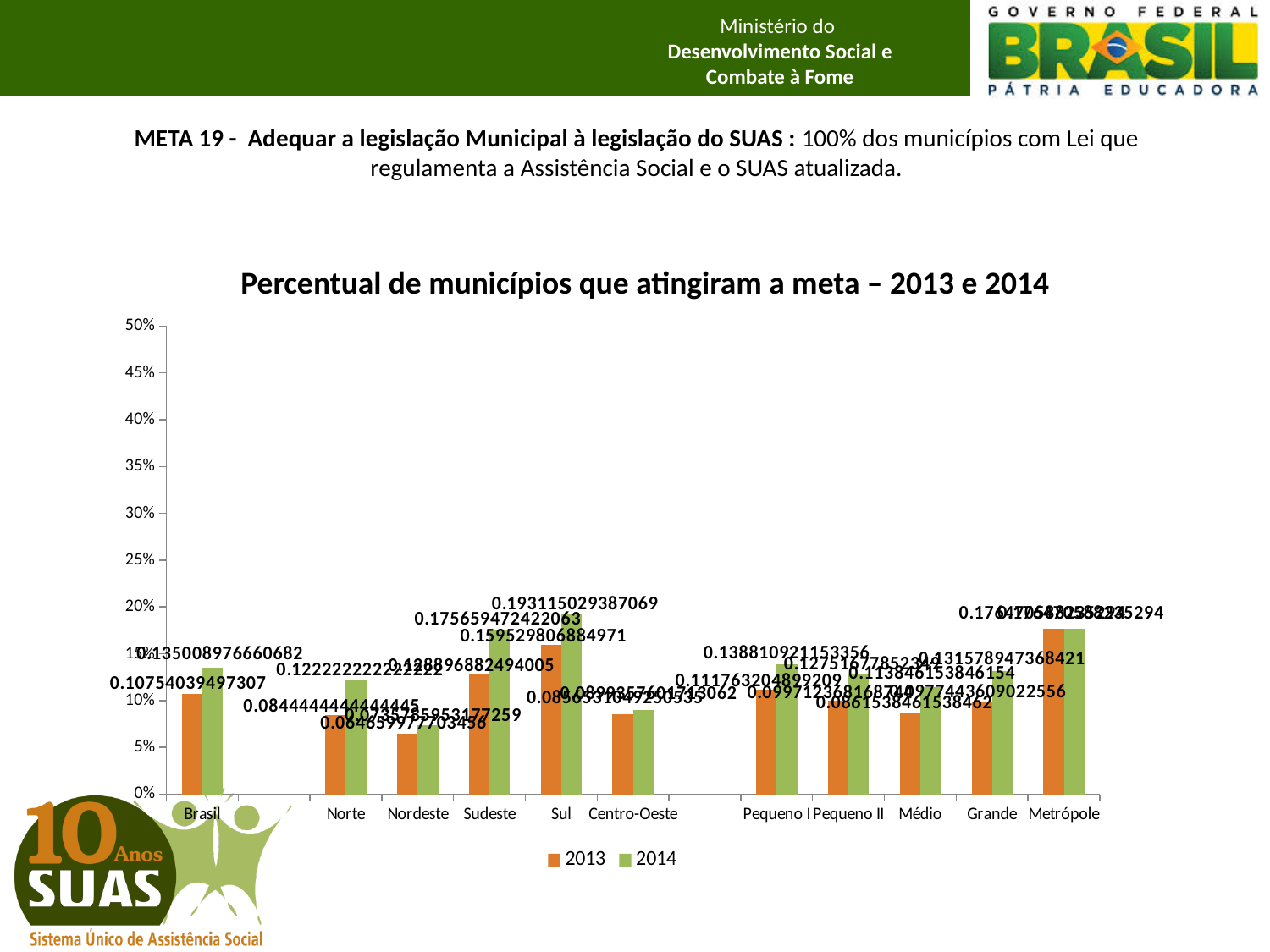
How many series does the legend list? 2 What is the 2014 value for Sudeste? 0.175659472422063 What kind of chart is shown on the slide? Bar chart Is the 2014 value for Sul greater or less than 15%? greater Which is larger for Norte, the 2013 value or the 2014 value? 2014 Is the 2013 value for Centro-Oeste greater or less than 10%? less How many categories are shown on the x axis of the chart? 11 What is the 2014 value for Sul? 0.193115029387069 What is the 2014 value for Brasil? 0.135008976660682 What is the 2014 value for Norte? 0.122222222222222 Which category has the lowest 2013 value? Nordeste Which category has the highest 2014 value? Sul